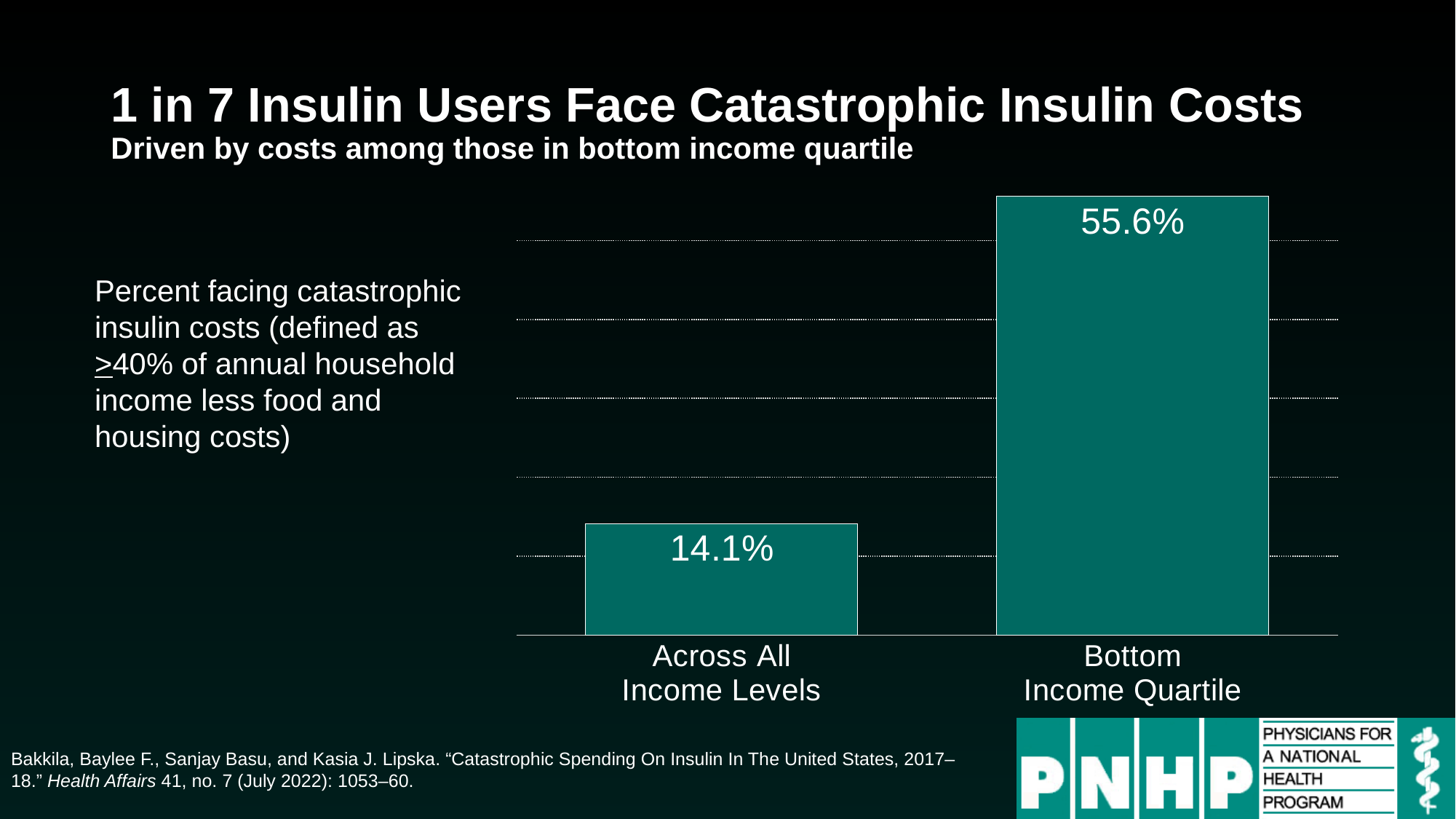
What percent of insulin users across all income levels face catastrophic insulin costs? 14.1% What percent of insulin users in the bottom income quartile face catastrophic insulin costs? 55.6% Which category has the lower percentage facing catastrophic insulin costs? Across All Income Levels What kind of chart is shown on the slide? bar chart How many categories are shown in the chart? 2 What is the difference in percentage points between the bottom income quartile and across all income levels? 41.5 What is the title of the slide? 1 in 7 Insulin Users Face Catastrophic Insulin Costs What colour are the bars in the chart? teal Which category has the higher percentage facing catastrophic insulin costs? Bottom Income Quartile Is the value for the bottom income quartile larger or smaller than the value across all income levels? larger